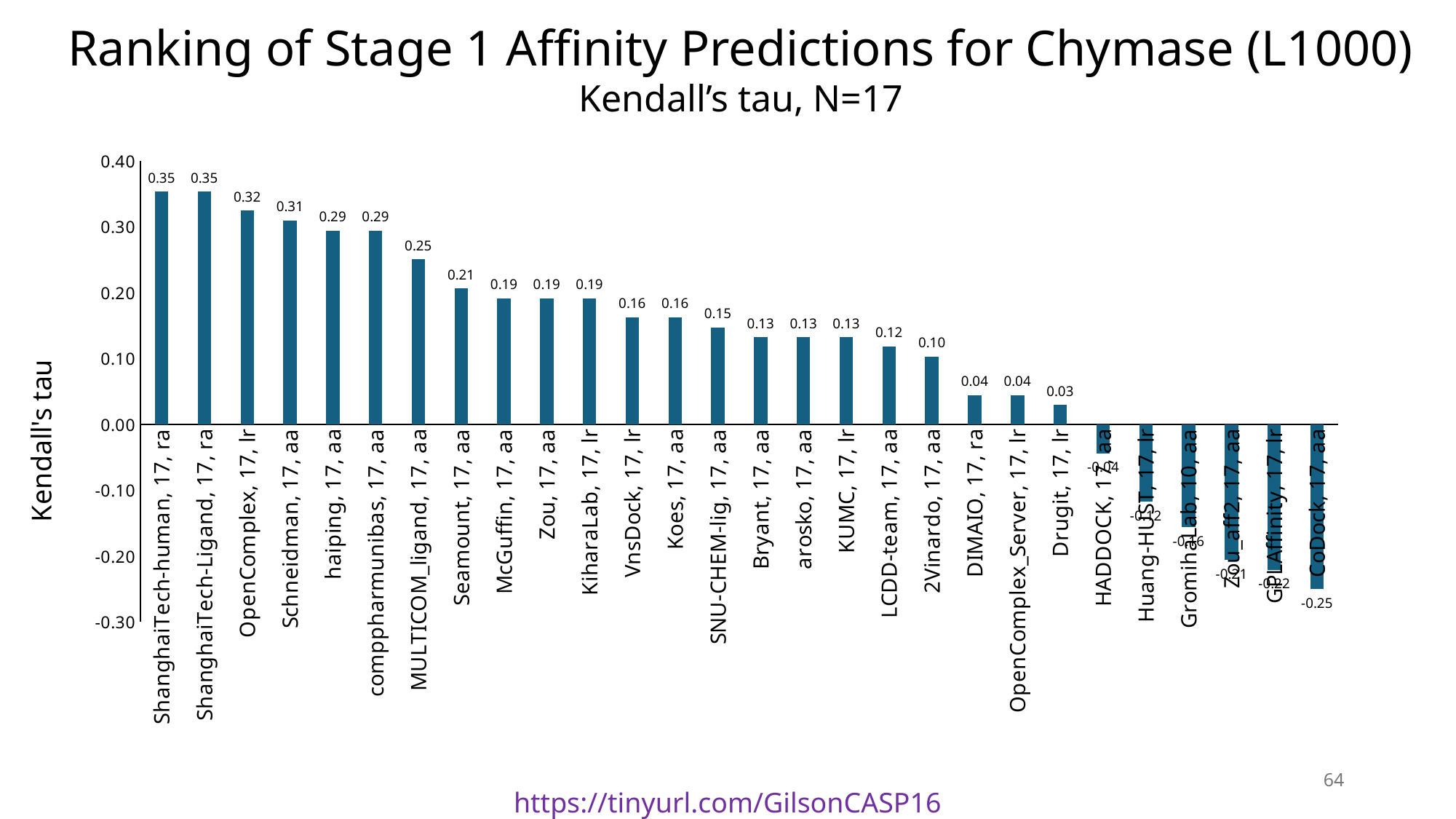
What is the Kendall's tau value for Drugit, 17, lr? 0.03 What is the difference between the Kendall's tau values of Schneidman, 17, aa and 2Vinardo, 17, aa? 0.21 What is the Kendall's tau value for CoDock, 17, aa? -0.25 What type of chart is shown on the slide? bar chart What is the Kendall's tau value for MULTICOM_ligand, 17, aa? 0.25 How many groups (bars) are shown in the chart? 28 What is the difference between the Kendall's tau values of KiharaLab, 17, lr and Bryant, 17, aa? 0.06 Do the Kendall's tau values rise or fall from left to right across the chart? fall What is the Kendall's tau value for OpenComplex, 17, lr? 0.32 Which has a higher Kendall's tau: Seamount, 17, aa or SNU-CHEM-lig, 17, aa? Seamount, 17, aa Which group has the lowest Kendall's tau in the chart? CoDock, 17, aa Is the value for Huang-HUST, 17, lr greater or less than -0.10? less